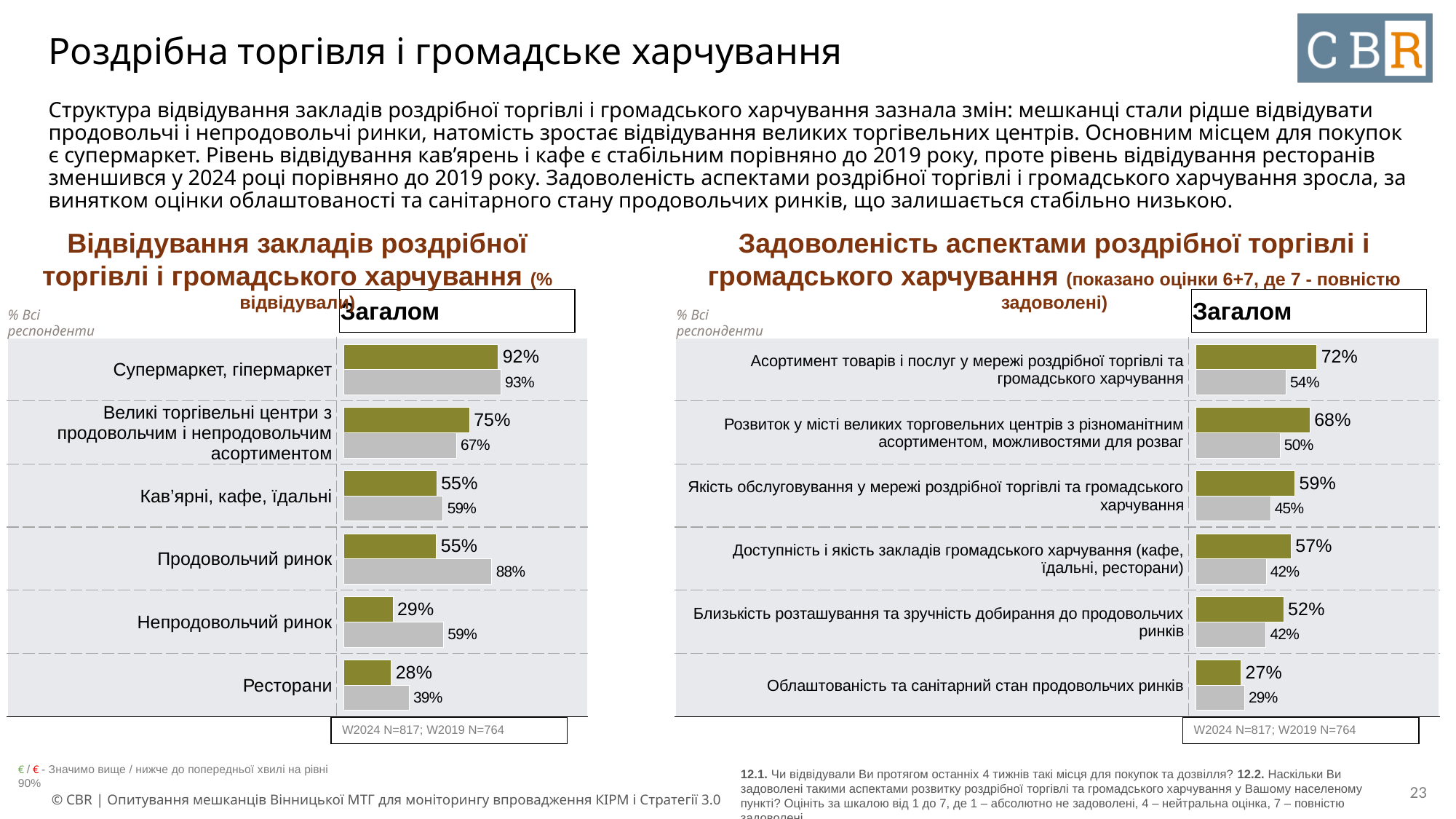
In the left chart (Відвідування закладів роздрібної торгівлі і громадського харчування), what is the value of the olive-green bar for Супермаркет, гіпермаркет? 92% What type of chart is used on the right side of the slide? bar chart In the left chart, which category has the lowest olive-green bar value? Ресторани In the left chart, which is larger for Великі торгівельні центри: the olive-green bar or the grey bar? the olive-green bar (75%) In the right chart, which aspect has the highest olive-green bar value? Асортимент товарів і послуг у мережі роздрібної торгівлі та громадського харчування In the right chart (Задоволеність аспектами роздрібної торгівлі і громадського харчування), what is the olive-green bar value for Якість обслуговування у мережі роздрібної торгівлі та громадського харчування? 59% In the left chart, what is the difference between the grey bar and the olive-green bar for Продовольчий ринок? 33 percentage points According to the note under the left chart, what are the sample sizes for W2024 and W2019? W2024 N=817; W2019 N=764 In the left chart, how many categories are shown? 6 In the right chart, what is the grey bar value for Облаштованість та санітарний стан продовольчих ринків? 29% In the right chart, what is the difference between the olive-green and grey bars for Розвиток у місті великих торговельних центрів? 18 percentage points In the left chart, what is the value of the grey bar for Продовольчий ринок? 88%